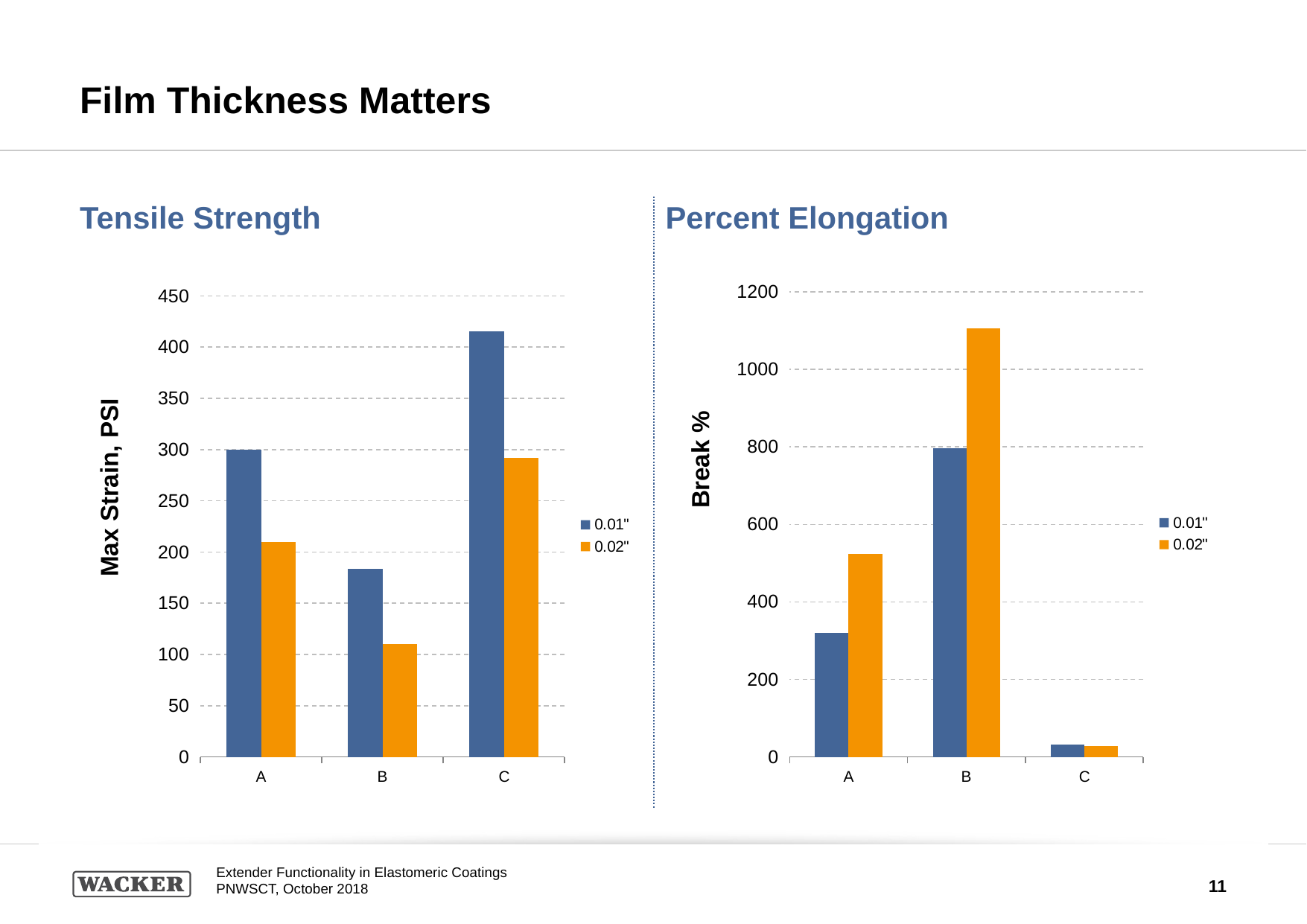
In the Tensile Strength chart, is the 0.01" value for C greater or less than 400? greater What kind of chart is the Tensile Strength chart? bar chart What is the y-axis title of the Percent Elongation chart? Break % In the Percent Elongation chart, which category has the lowest value for the 0.01" series? C In the Percent Elongation chart, which category has the highest value for the 0.02" series? B In the Tensile Strength chart, for category A, which series has the larger value, 0.01" or 0.02"? 0.01" In the Tensile Strength chart, which category has the lowest value for the 0.02" series? B In the Percent Elongation chart, for category A, which series has the larger value, 0.01" or 0.02"? 0.02" In the Percent Elongation chart, is the 0.02" value for B greater or less than 1000? greater In the Tensile Strength chart, which category has the highest value for the 0.01" series? C How many series does the legend of the Tensile Strength chart list? 2 How many categories are shown on the x axis of the Tensile Strength chart? 3